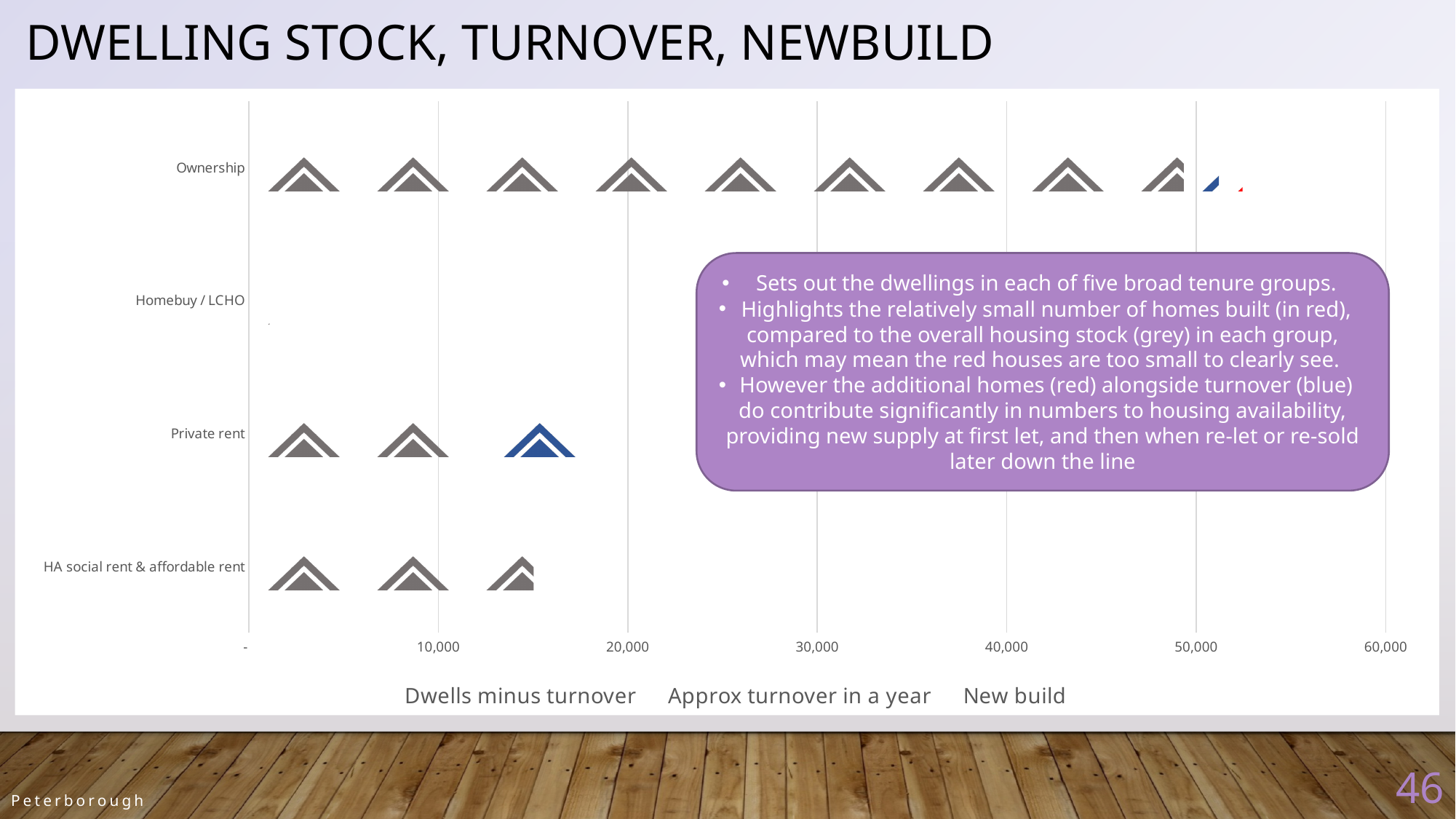
Which tenure category has the smallest total on the chart? Homebuy / LCHO How many series does the chart legend list? 3 Is the total value for Ownership greater or less than 50,000? greater Which has the larger total, Private rent or HA social rent & affordable rent? Private rent Which series in the legend is shown in red? New build Which tenure category has the largest total dwelling stock on the chart? Ownership How many tenure categories are plotted on the chart? 4 Is the total value for HA social rent & affordable rent greater or less than 10,000? greater Is the total value for Private rent greater or less than 20,000? less What is the title of the slide containing the chart? DWELLING STOCK, TURNOVER, NEWBUILD What kind of chart is shown on the slide? Bar chart